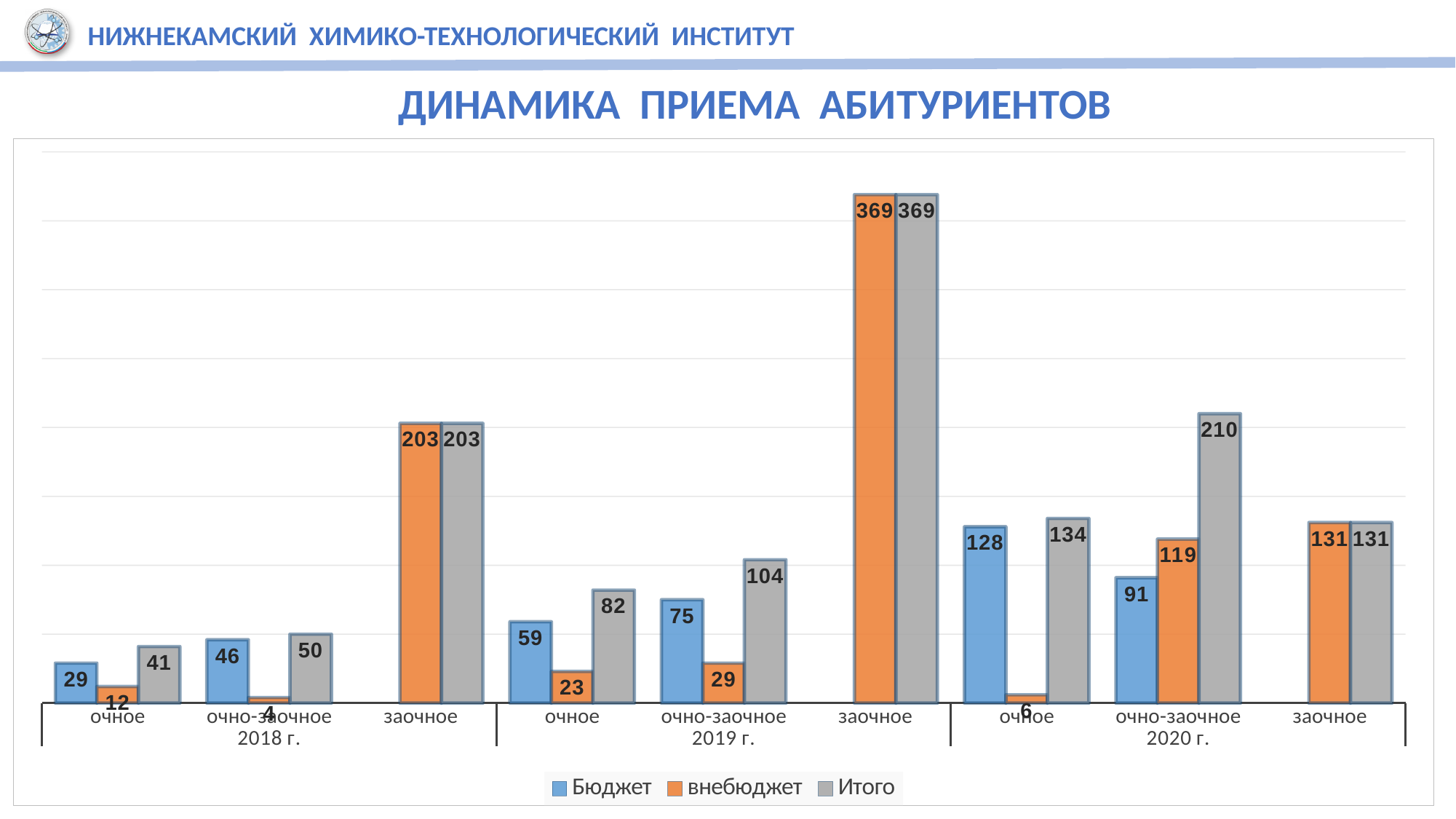
What is the difference between the Итого values for очно-заочное in 2020 г. and 2019 г.? 106 What is the Бюджет value for очно-заочное in 2019 г.? 75 How does the Итого value for очное change from 2018 г. to 2020 г.? It rises (41, 82, 134) What is the Итого value for заочное in 2019 г.? 369 Which category has the highest Итого value? заочное 2019 г. Which is larger: the Бюджет value for очно-заочное in 2020 г. or the внебюджет value for очно-заочное in 2020 г.? внебюджет (119) Which category has the lowest Итого value? очное 2018 г. How many series does the legend list? 3 What is the Бюджет value for очное in 2020 г.? 128 What kind of chart is shown on the slide? Bar chart What is the title of the chart? ДИНАМИКА ПРИЕМА АБИТУРИЕНТОВ What is the внебюджет value for очно-заочное in 2018 г.? 4